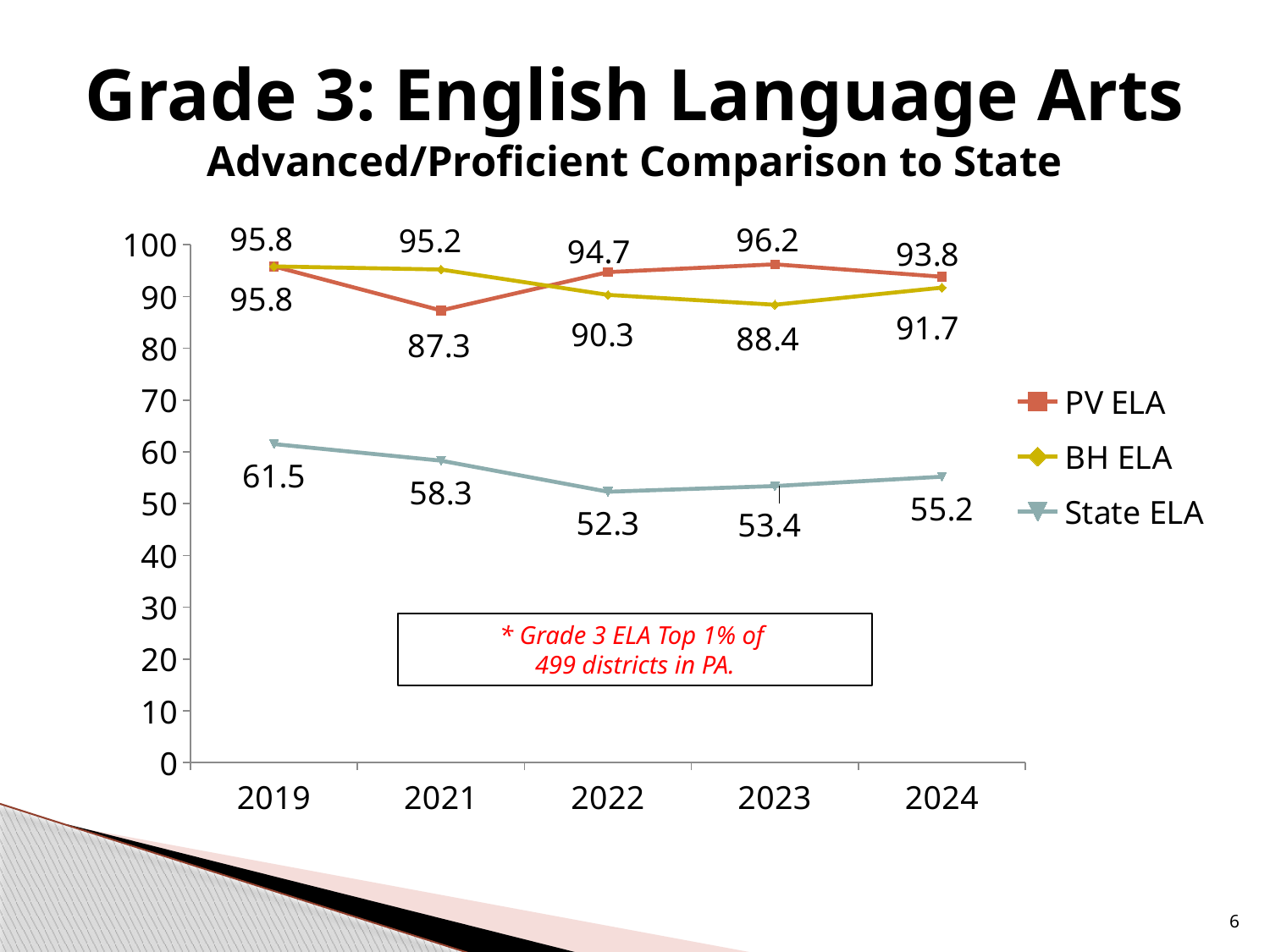
What is the PV ELA value for 2021? 87.3 What is the BH ELA value for 2024? 91.7 Does the State ELA value rise or fall from 2019 to 2022? fall In which year is the PV ELA value highest? 2023 What is the PV ELA value for 2023? 96.2 What is the State ELA value for 2019? 61.5 What kind of chart is shown on the slide? line chart What is the difference between the PV ELA and State ELA values in 2024? 38.6 In which year is the State ELA value lowest? 2022 How many years are shown on the x axis? 5 How many series does the legend list? 3 In 2022, which is larger, PV ELA or BH ELA? PV ELA